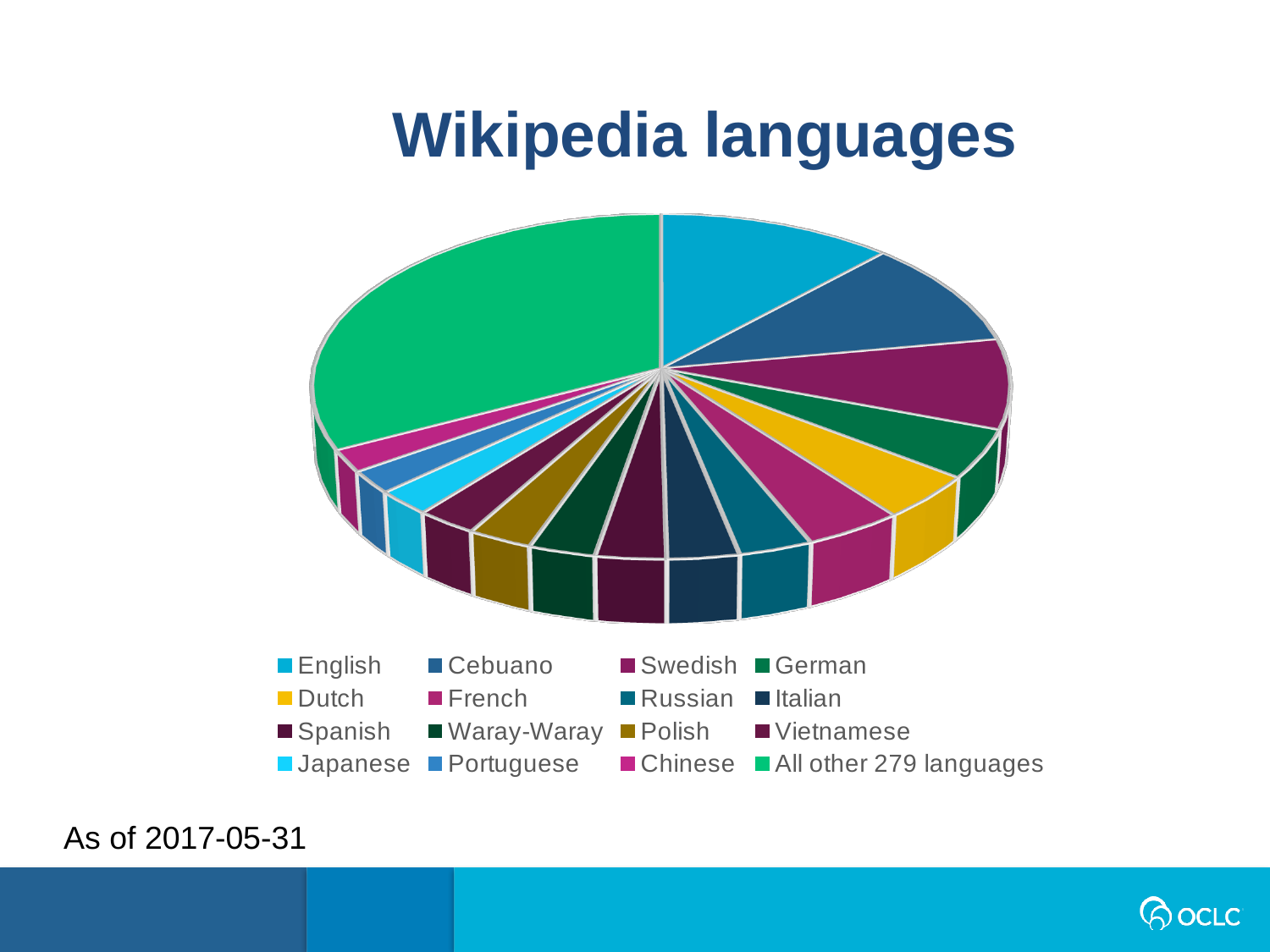
Which slice is larger, All other 279 languages or English? All other 279 languages Which slice is larger, Cebuano or Portuguese? Cebuano Which slice is larger, Swedish or Chinese? Swedish What kind of chart is shown on the slide? pie chart How many categories does the legend of the pie chart list? 16 As of what date is the chart data, according to the note on the slide? 2017-05-31 Which is the last category listed in the legend? All other 279 languages What is the title of the chart? Wikipedia languages Which category has the largest slice of the pie? All other 279 languages